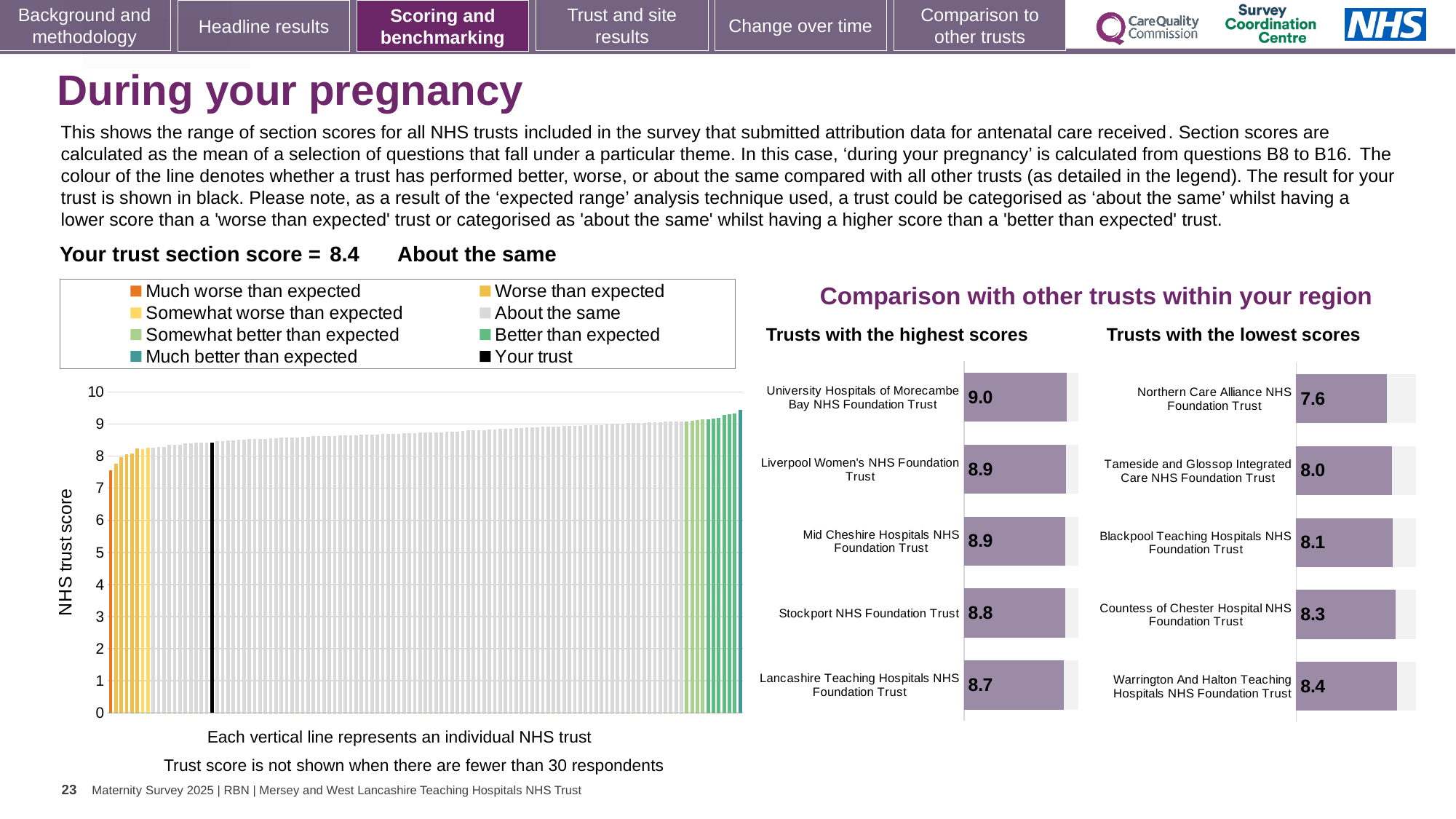
In the 'Trusts with the lowest scores' chart, which has the larger score: Tameside and Glossop Integrated Care NHS Foundation Trust or Warrington And Halton Teaching Hospitals NHS Foundation Trust? Warrington And Halton Teaching Hospitals NHS Foundation Trust In the 'Trusts with the lowest scores' chart, what is the score for Countess of Chester Hospital NHS Foundation Trust? 8.3 What kind of chart is the 'Trusts with the lowest scores' chart? Bar chart In the 'Trusts with the lowest scores' chart, what is the score for Northern Care Alliance NHS Foundation Trust? 7.6 How many entries does the legend of the NHS trust score chart on the left list? 8 In the 'Trusts with the highest scores' chart, what is the difference between the scores of University Hospitals of Morecambe Bay NHS Foundation Trust and Lancashire Teaching Hospitals NHS Foundation Trust? 0.3 In the NHS trust score chart on the left, do the bars rise or fall from left to right? Rise In the 'Trusts with the highest scores' chart, which trust has the highest score? University Hospitals of Morecambe Bay NHS Foundation Trust In the 'Trusts with the highest scores' chart, what is the score for University Hospitals of Morecambe Bay NHS Foundation Trust? 9.0 In the 'Trusts with the lowest scores' chart, which trust has the lowest score? Northern Care Alliance NHS Foundation Trust In the NHS trust score chart on the left, is the value of the black 'Your trust' bar greater or less than 8? greater How many trusts are shown in the 'Trusts with the highest scores' chart? 5